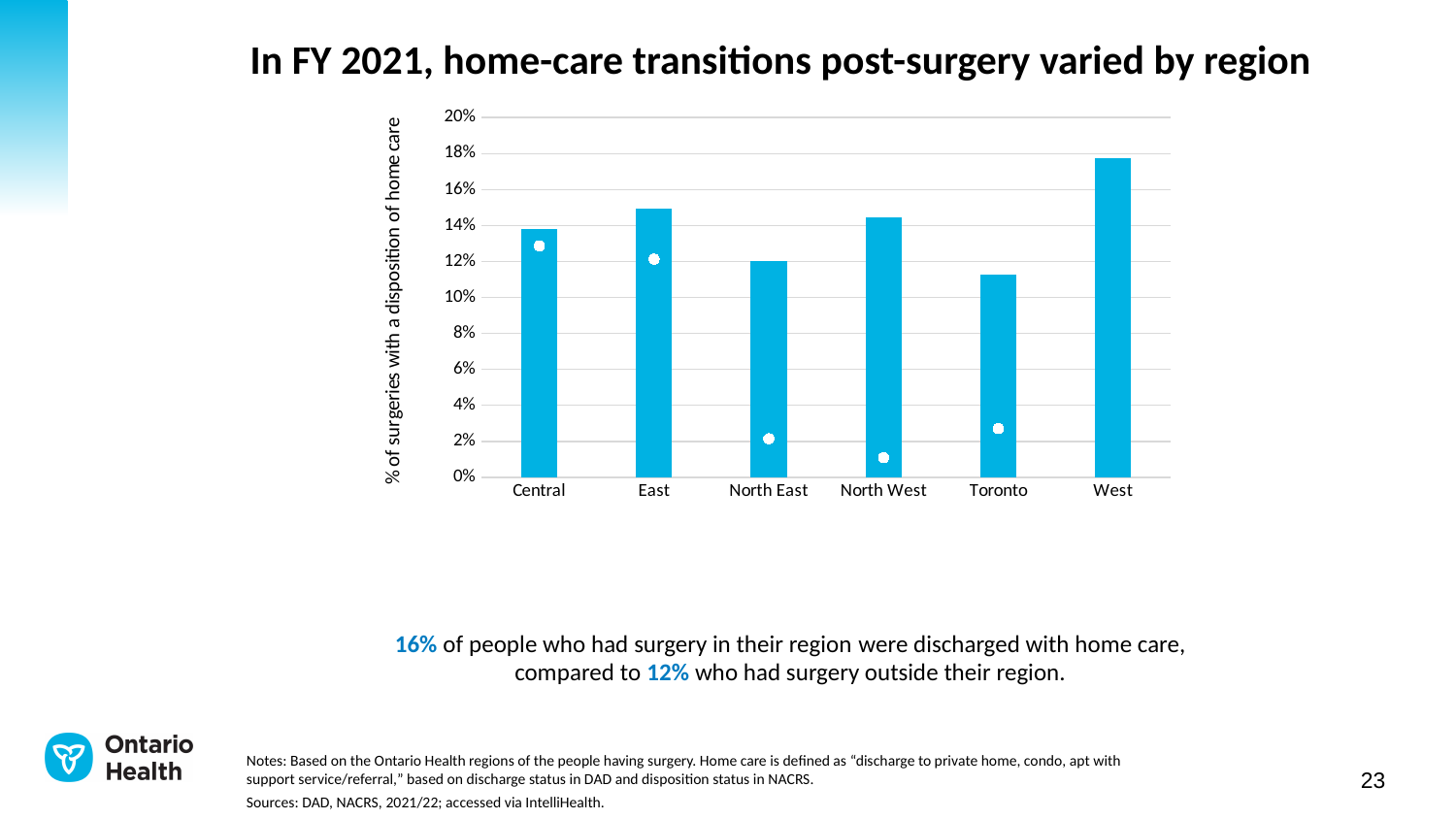
Which region has a higher value, East or North East? East How many regions are shown on the x axis of the chart? 6 Is the value for East greater or less than 14%? greater Which region has the highest percentage of surgeries with a disposition of home care? West Is the value for West greater or less than 16%? greater Is the value for North East greater or less than 14%? less Which region has the lowest percentage of surgeries with a disposition of home care? Toronto What is the label on the y axis of the chart? % of surgeries with a disposition of home care Which region has a higher value, Central or Toronto? Central What kind of chart is shown on the slide? Bar chart